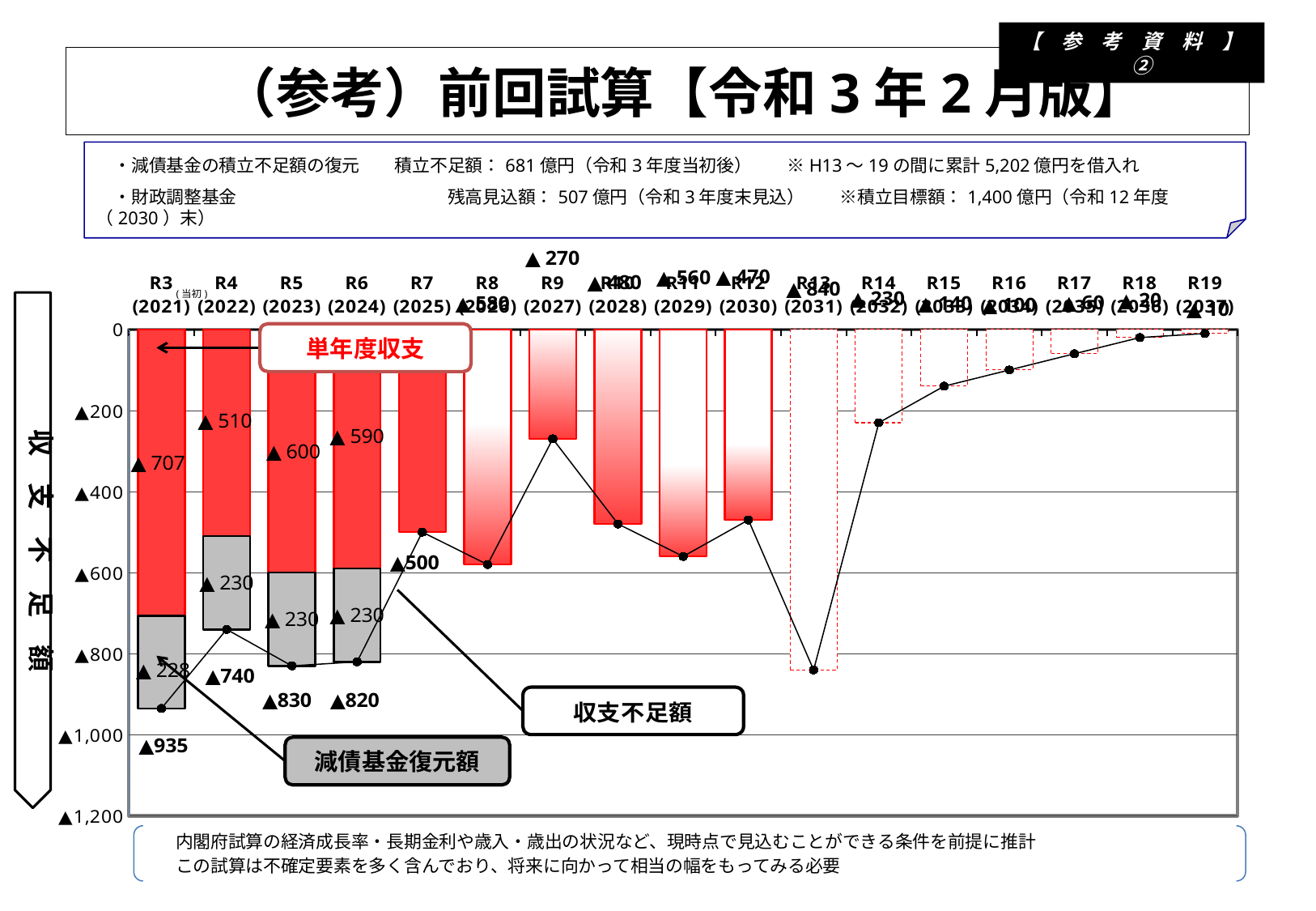
What is the 収支不足額 for R3 (2021)? ▲935 What is the difference between the 単年度収支 values for R3 (2021) and R4 (2022)? 197 What does the red bar represent according to the label on the chart? 単年度収支 What kind of chart is shown on the slide? a stacked bar chart with a line What is the 減債基金復元額 (grey bar) value for R4 (2022)? ▲230 What is the total of the stacked bar for R5 (2023)? ▲830 Which year has the largest 収支不足額 (the lowest point on the line)? R3 (2021) What is the value shown for R14 (2032)? ▲230 What is the value shown for R9 (2027)? ▲270 What is the 単年度収支 (red bar) value for R3 (2021)? ▲707 How many fiscal years are shown on the x axis? 17 Which has the larger 単年度収支 (red bar) value, R5 (2023) or R6 (2024)? R5 (2023)